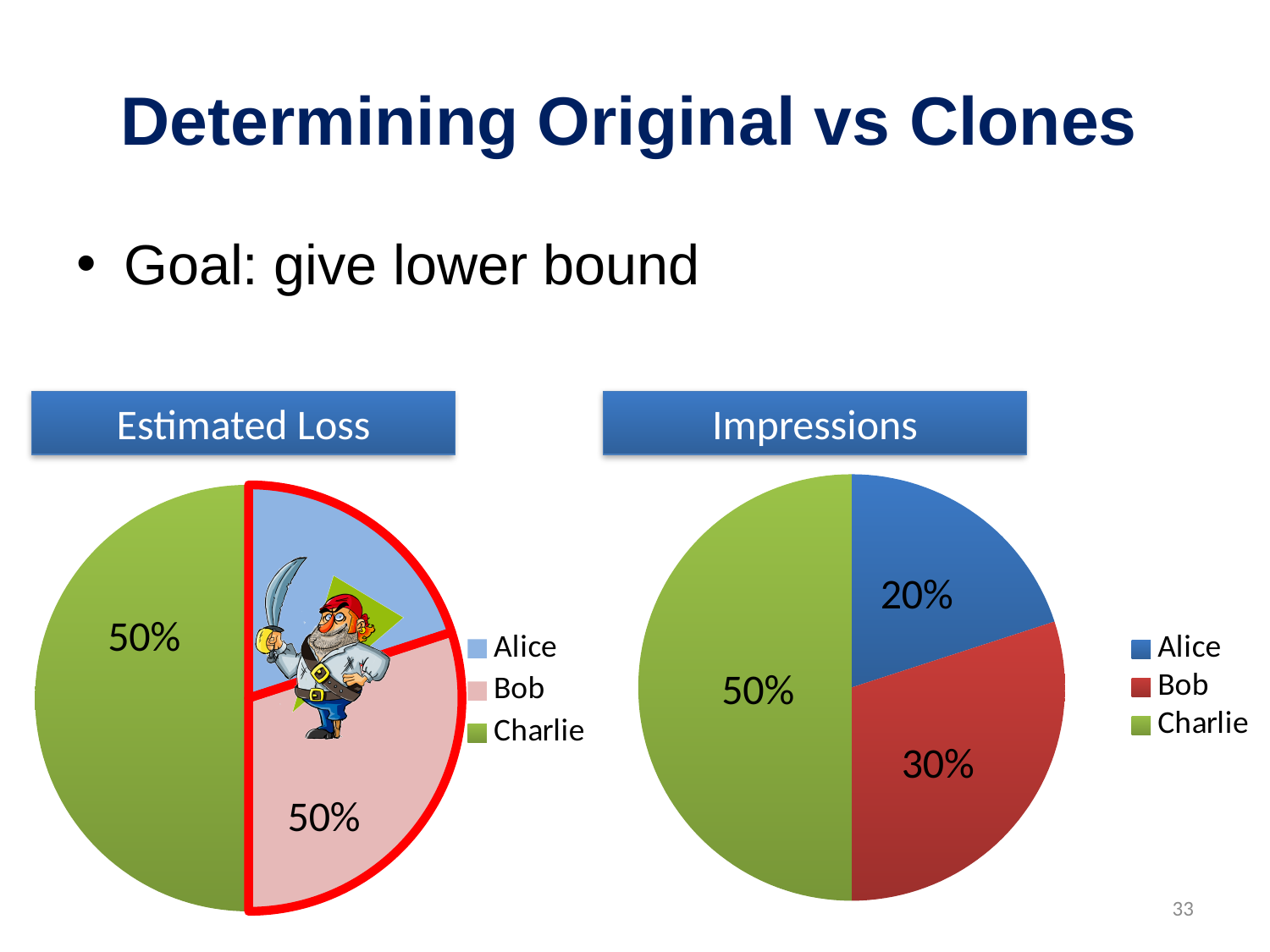
In the Impressions chart, what share of impressions does Alice have? 20% In the Impressions chart, who has the larger share, Alice or Bob? Bob In the Impressions chart, what share of impressions does Bob have? 30% In the Estimated Loss chart, what share is labelled for Bob? 50% In the Impressions chart, what share of impressions does Charlie have? 50% What is the title of the chart on the left side of the slide? Estimated Loss In the Impressions chart, which person has the largest slice? Charlie What type of chart is the Impressions chart? Pie chart How many entries does the legend of the Impressions chart list? 3 In the Impressions chart, how much larger is Charlie's share than Alice's share? 30% In the Impressions chart, which person has the smallest slice? Alice In the Estimated Loss chart, what share is labelled for Charlie? 50%